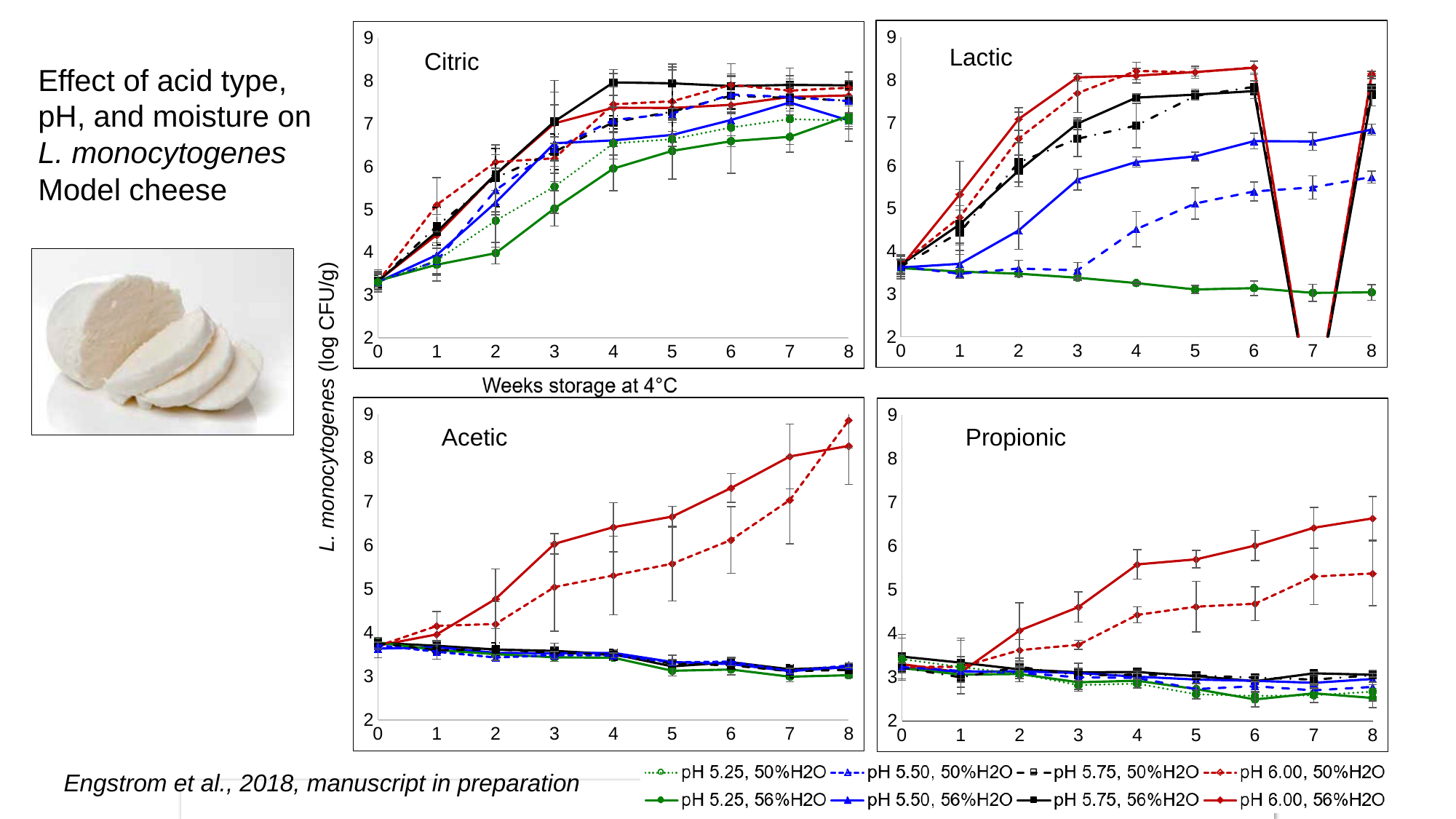
What is the shared y-axis label of the charts? L. monocytogenes (log CFU/g) In the Citric chart, is the value for pH 5.75, 56%H2O at week 4 greater or less than 7? greater What is the x-axis label shown under the Citric chart? Weeks storage at 4°C In the Acetic chart, is the value for pH 6.00, 56%H2O at week 8 greater or less than 7? greater In the Acetic chart at week 8, which is larger: pH 6.00, 50%H2O or pH 5.25, 56%H2O? pH 6.00, 50%H2O How many series does the legend list? 8 In the Propionic chart, does the pH 6.00, 56%H2O series rise or fall from week 0 to week 8? rise In the Acetic chart, how many week points are plotted along the x axis? 9 What kind of chart is the Citric chart? line chart In the Propionic chart, is the value for pH 6.00, 50%H2O at week 8 greater or less than 6? less In the Lactic chart, does the pH 5.25, 56%H2O series rise or fall from week 0 to week 8? fall